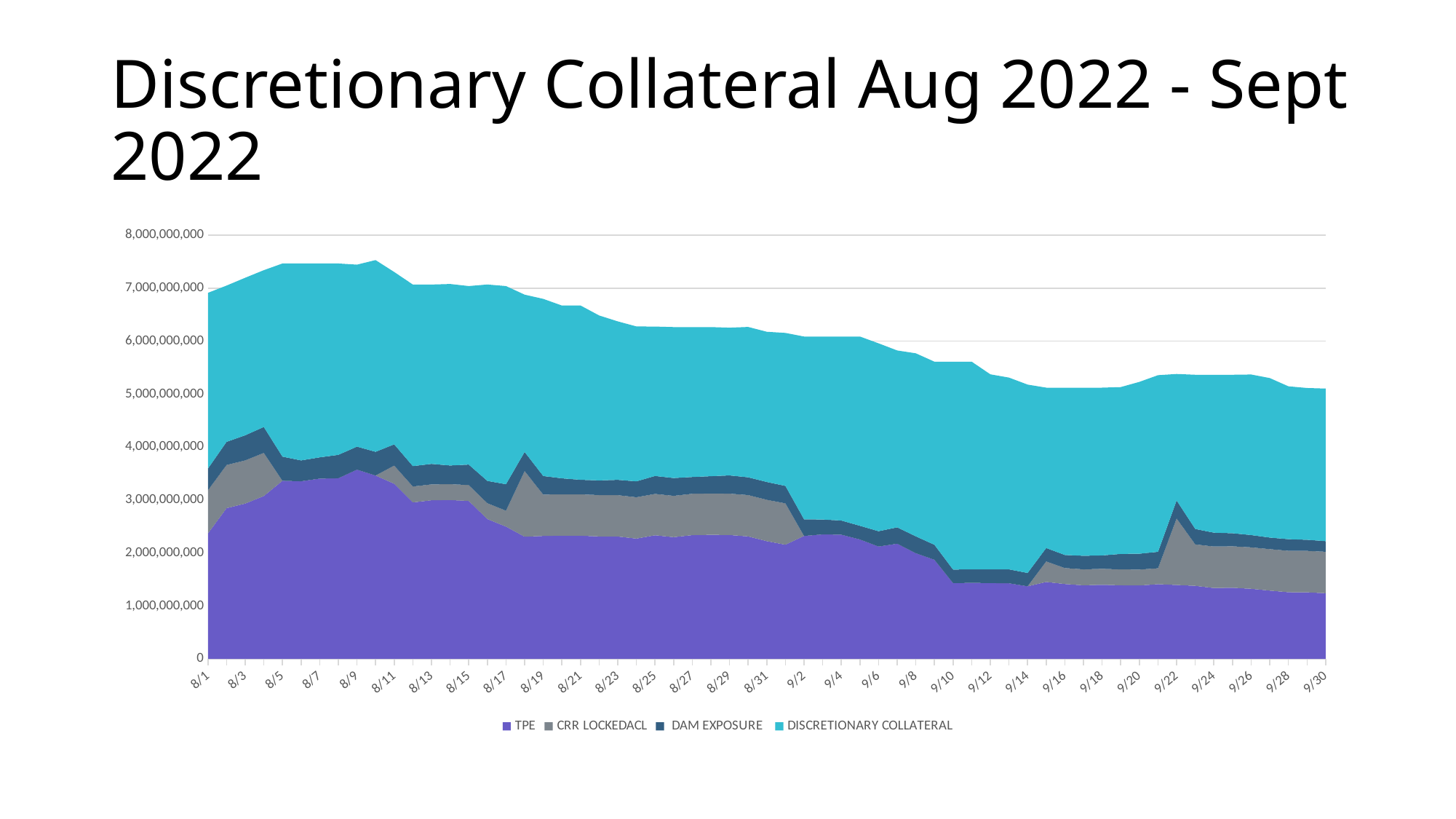
On 8/1, which series has the larger band: TPE or CRR LOCKEDACL? TPE Is the TPE value on 9/30 greater or less than 2,000,000,000? less Does the stacked total generally rise or fall from 8/1 to 9/30? fall How many series does the legend list? 4 What kind of chart is shown on the slide? Stacked area chart Is the TPE value on 8/9 greater or less than 3,000,000,000? greater What is the title of the chart? Discretionary Collateral Aug 2022 - Sept 2022 Is the stacked total on 8/5 greater or less than 7,000,000,000? greater On 9/30, which series has the larger band: TPE or DISCRETIONARY COLLATERAL? DISCRETIONARY COLLATERAL Which series is shown in the light teal colour at the top of the stack? DISCRETIONARY COLLATERAL How many date labels are shown on the x axis? 31